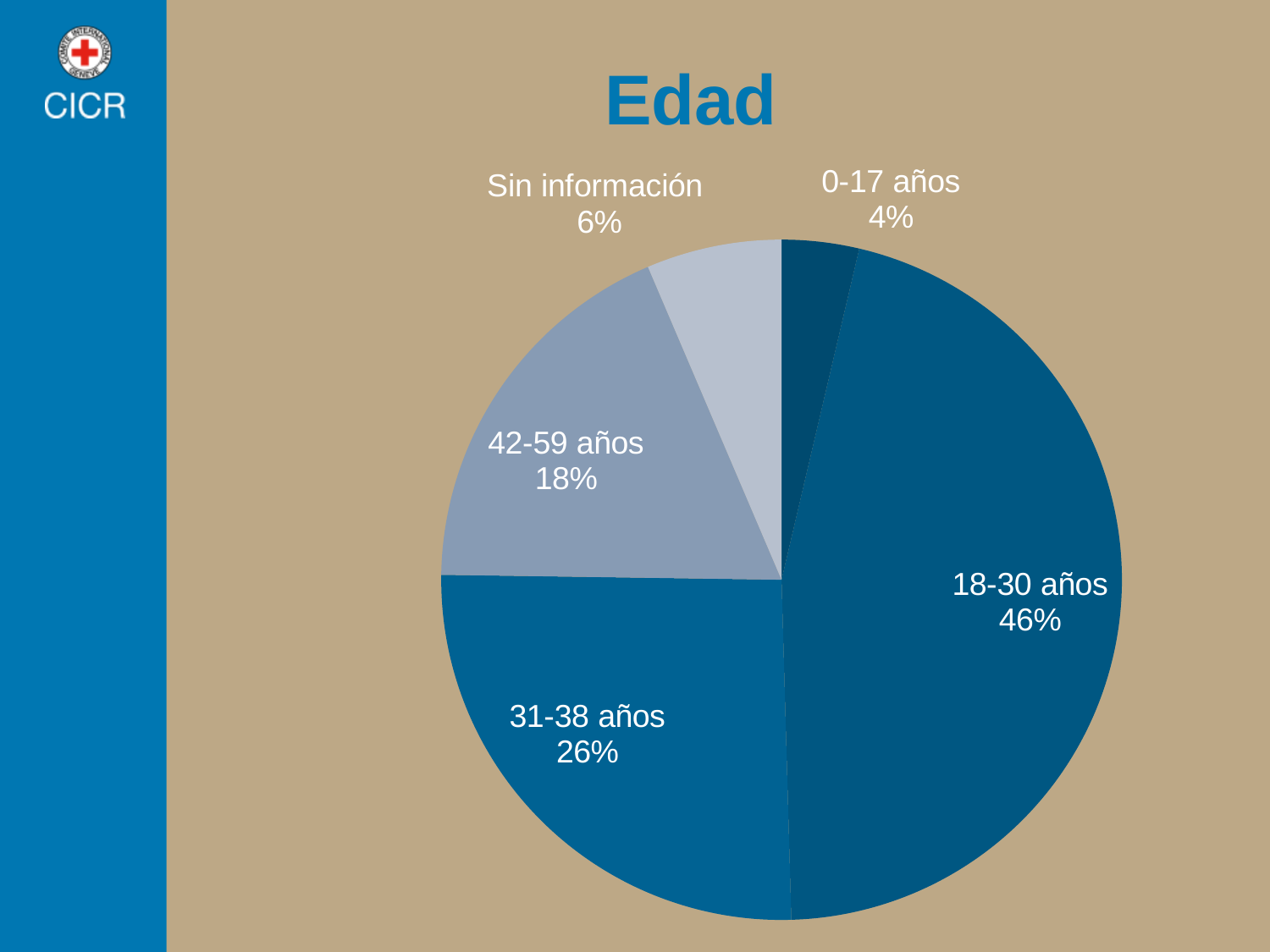
What percentage does the 18-30 años slice represent? 46% What percentage does the 42-59 años slice represent? 18% What percentage does the 31-38 años slice represent? 26% How many slices does the pie chart have? 5 Which category has the smallest share of the pie? 0-17 años What kind of chart is shown on the slide? Pie chart Which is larger, the 42-59 años slice or the Sin información slice? 42-59 años Which age category has the largest share of the pie? 18-30 años What is the combined share of the 0-17 años and Sin información slices? 10% What percentage is labelled Sin información? 6% What is the difference in percentage points between the 18-30 años and 31-38 años slices? 20 What is the title of the chart? Edad